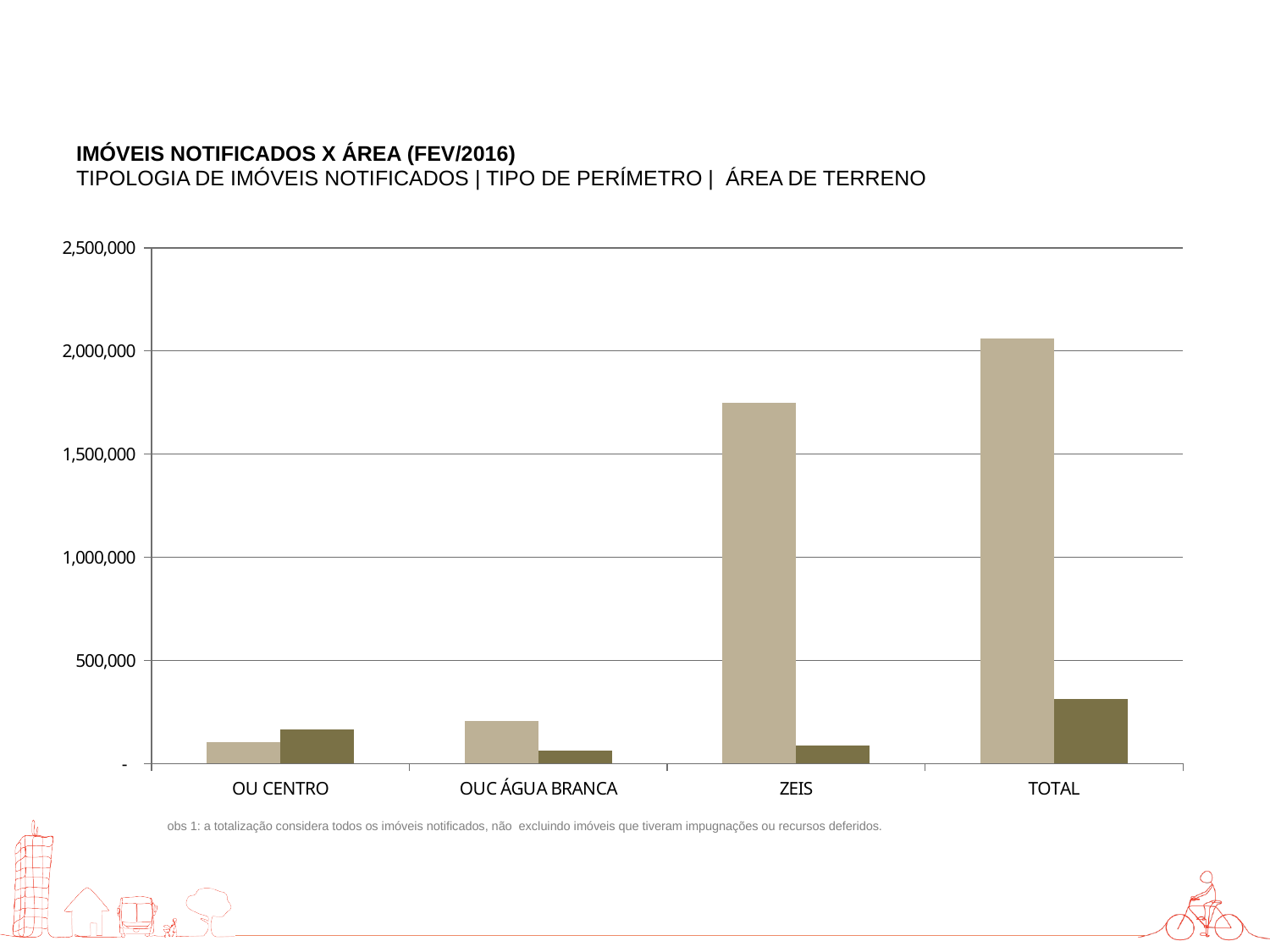
Which category has the tallest light tan bar? TOTAL Is the light tan bar for ZEIS greater or less than 1,500,000? greater Which has the larger light tan bar, ZEIS or OUC ÁGUA BRANCA? ZEIS Is the dark olive bar for TOTAL greater or less than 500,000? less What kind of chart is shown on the slide? bar chart Which category has the tallest dark olive bar? TOTAL What is the bold title printed above the chart? IMÓVEIS NOTIFICADOS X ÁREA (FEV/2016) Which category has the shortest light tan bar? OU CENTRO How many bars are plotted for each category on the chart? 2 Is the light tan bar for TOTAL greater or less than 2,000,000? greater How many categories are shown on the x axis of the chart? 4